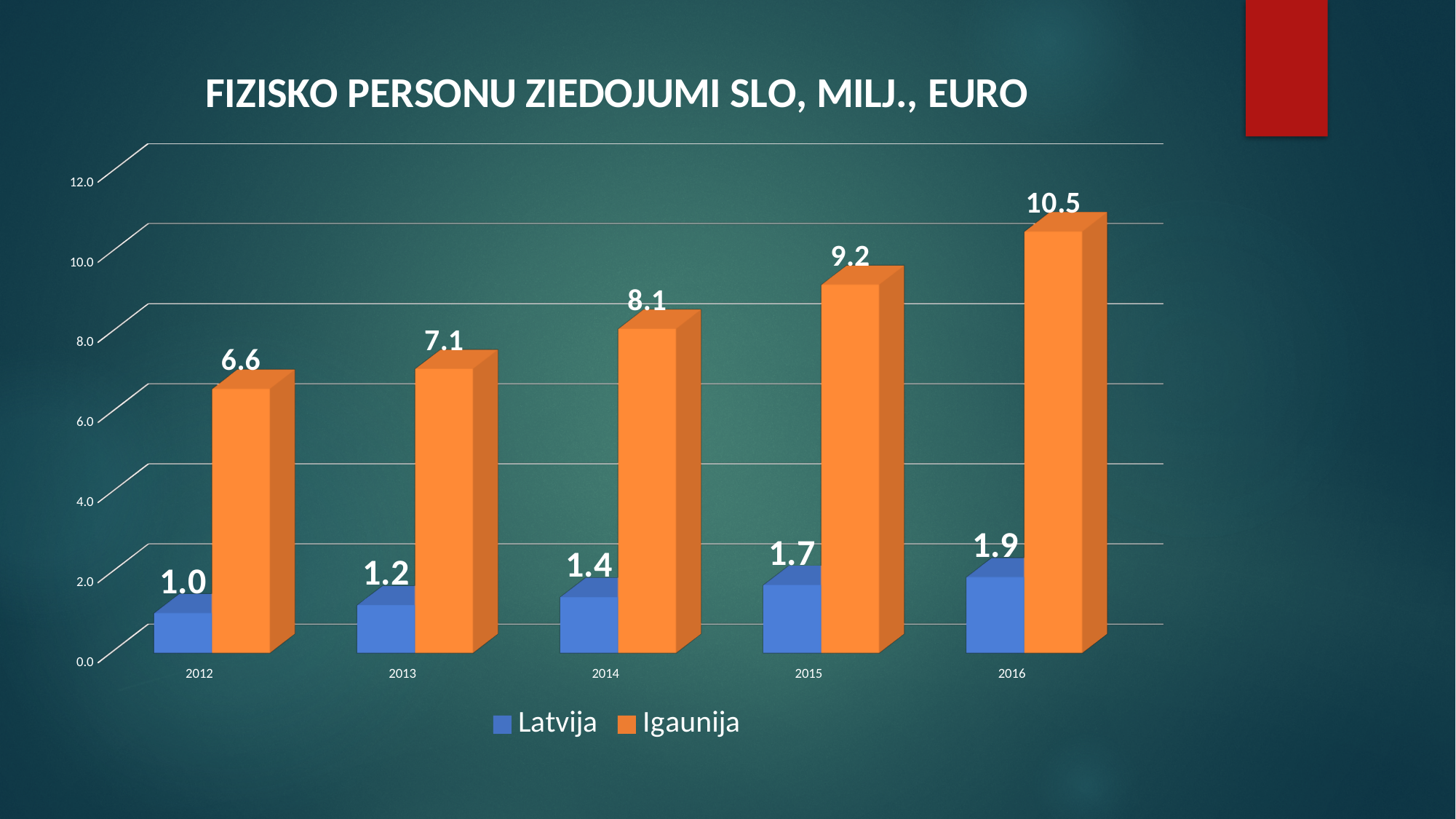
How many series does the legend list? 2 Do the Latvija values rise or fall from 2012 to 2016? rise Is the value for Igaunija in 2015 greater or less than 8.0? greater In which year is the Latvija value lowest? 2012 What kind of chart is shown on the slide? bar chart What is the value for Igaunija in 2014? 8.1 What is the difference between the Igaunija values for 2013 and 2012? 0.5 Which is larger in 2013: the value for Latvija or the value for Igaunija? Igaunija How many years are shown on the x axis? 5 What is the difference between the Igaunija and Latvija values in 2016? 8.6 What is the value for Latvija in 2015? 1.7 In which year is the Igaunija value highest? 2016